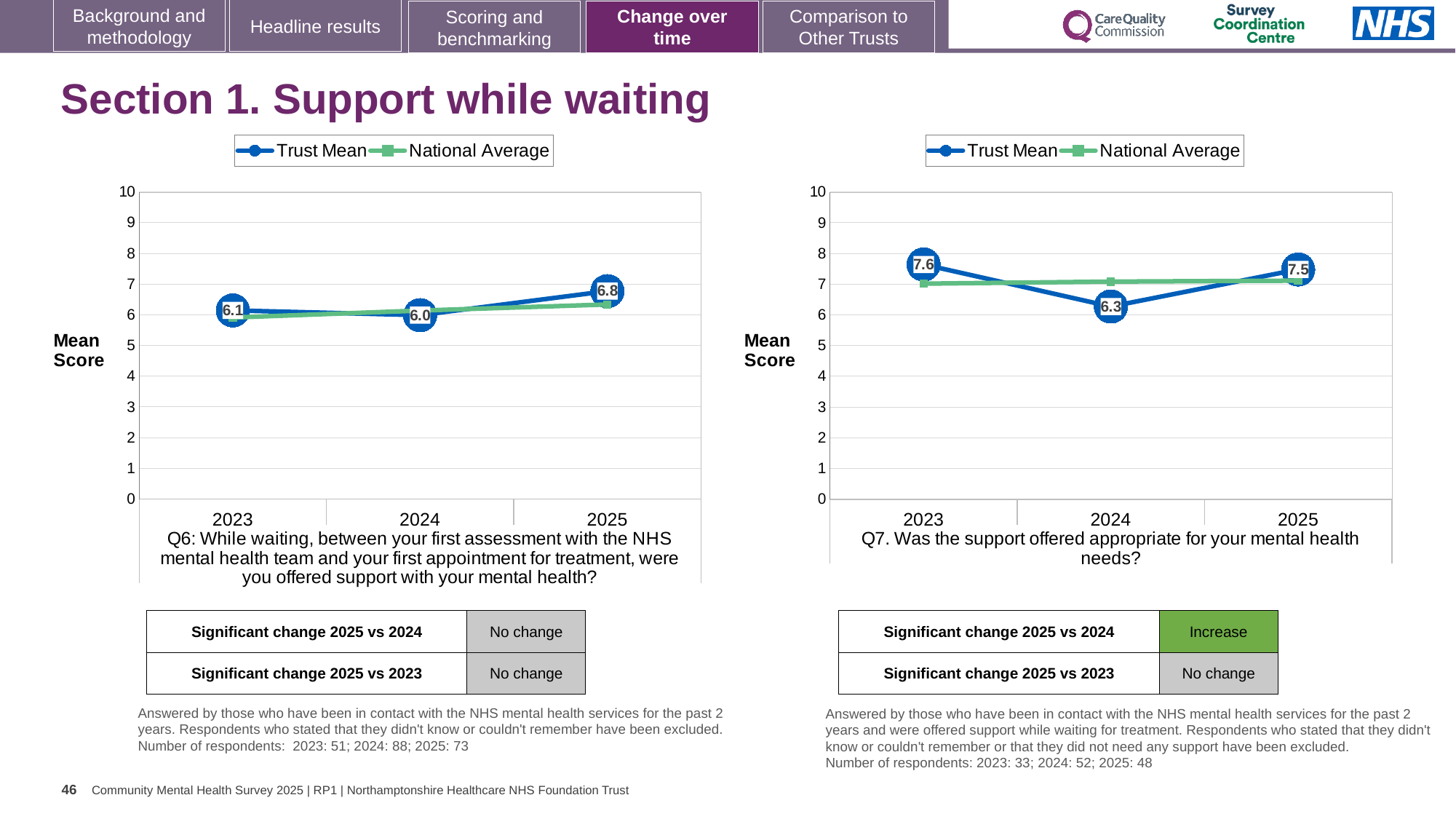
On the left chart (Q6), which year has the highest Trust Mean score? 2025 On the left chart (Q6), what is the Trust Mean score for 2025? 6.8 On the left chart (Q6), is the National Average value for 2025 greater or less than 7? less On the right chart (Q7), what is the difference between the Trust Mean scores for 2023 and 2024? 1.3 On the right chart (Q7), what is the Trust Mean score for 2023? 7.6 On the right chart (Q7), is the Trust Mean score higher in 2023 or in 2024? 2023 On the left chart (Q6), what is the difference between the Trust Mean scores for 2025 and 2024? 0.8 On the left chart (Q6), what is the Trust Mean score for 2023? 6.1 What type of chart is used on the left of the slide (Q6)? Line chart How many series does the legend of the right chart (Q7) list? 2 On the right chart (Q7), what is the Trust Mean score for 2024? 6.3 On the right chart (Q7), which year has the lowest Trust Mean score? 2024